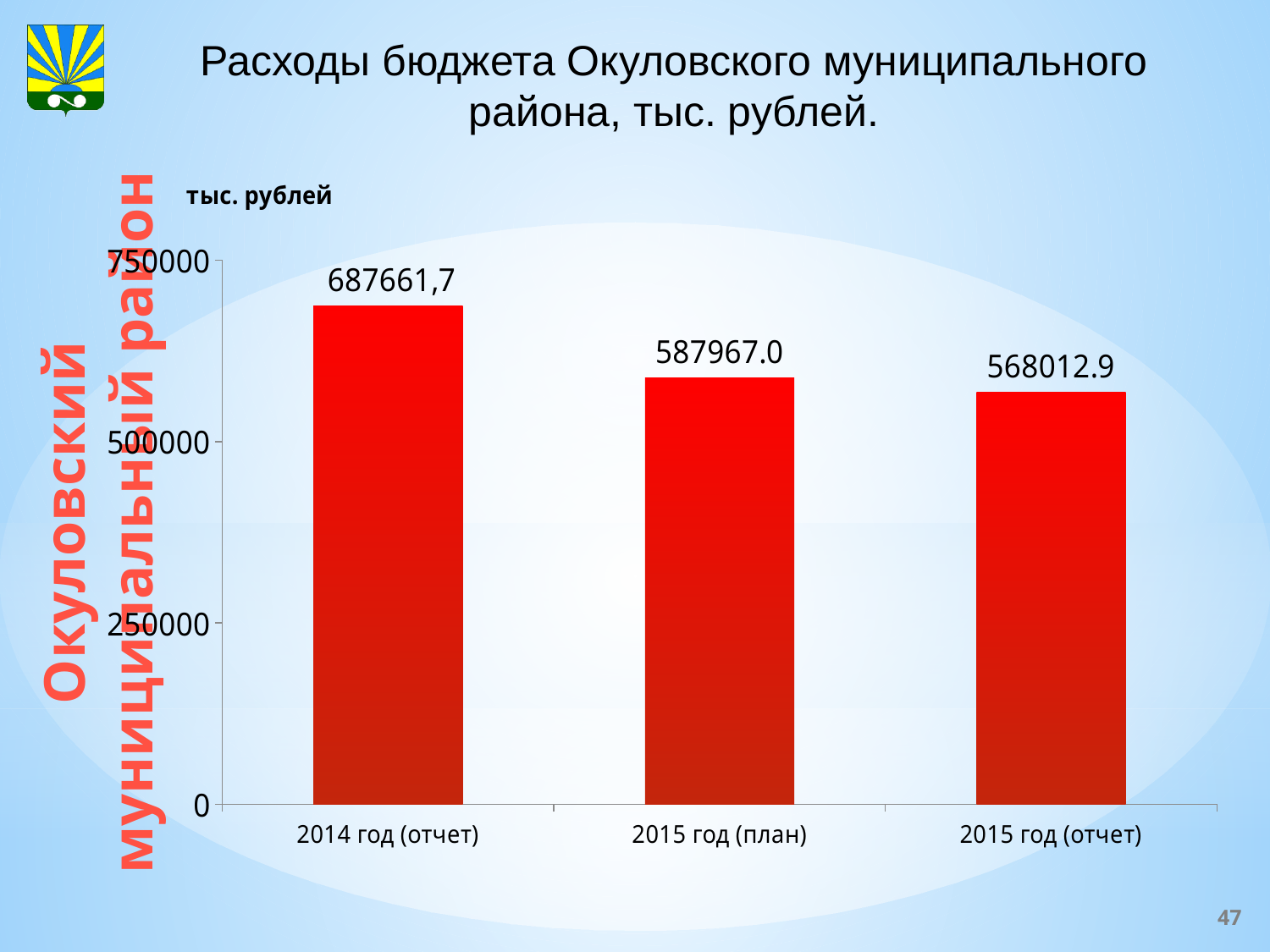
What kind of chart is shown on the slide? bar chart What is the difference between the values for 2014 год (отчет) and 2015 год (план)? 99694.7 What is the value for 2015 год (план)? 587967.0 Which is larger, the value for 2015 год (план) or the value for 2015 год (отчет)? 2015 год (план) Which category has the highest value? 2014 год (отчет) Which category has the lowest value? 2015 год (отчет) What is the value for 2014 год (отчет)? 687661,7 What is the difference between the values for 2015 год (план) and 2015 год (отчет)? 19954.1 How many categories are shown on the x axis? 3 Is the value for 2014 год (отчет) greater or less than 500000? greater Do the values rise or fall from left to right along the x axis? fall What is the value for 2015 год (отчет)? 568012.9